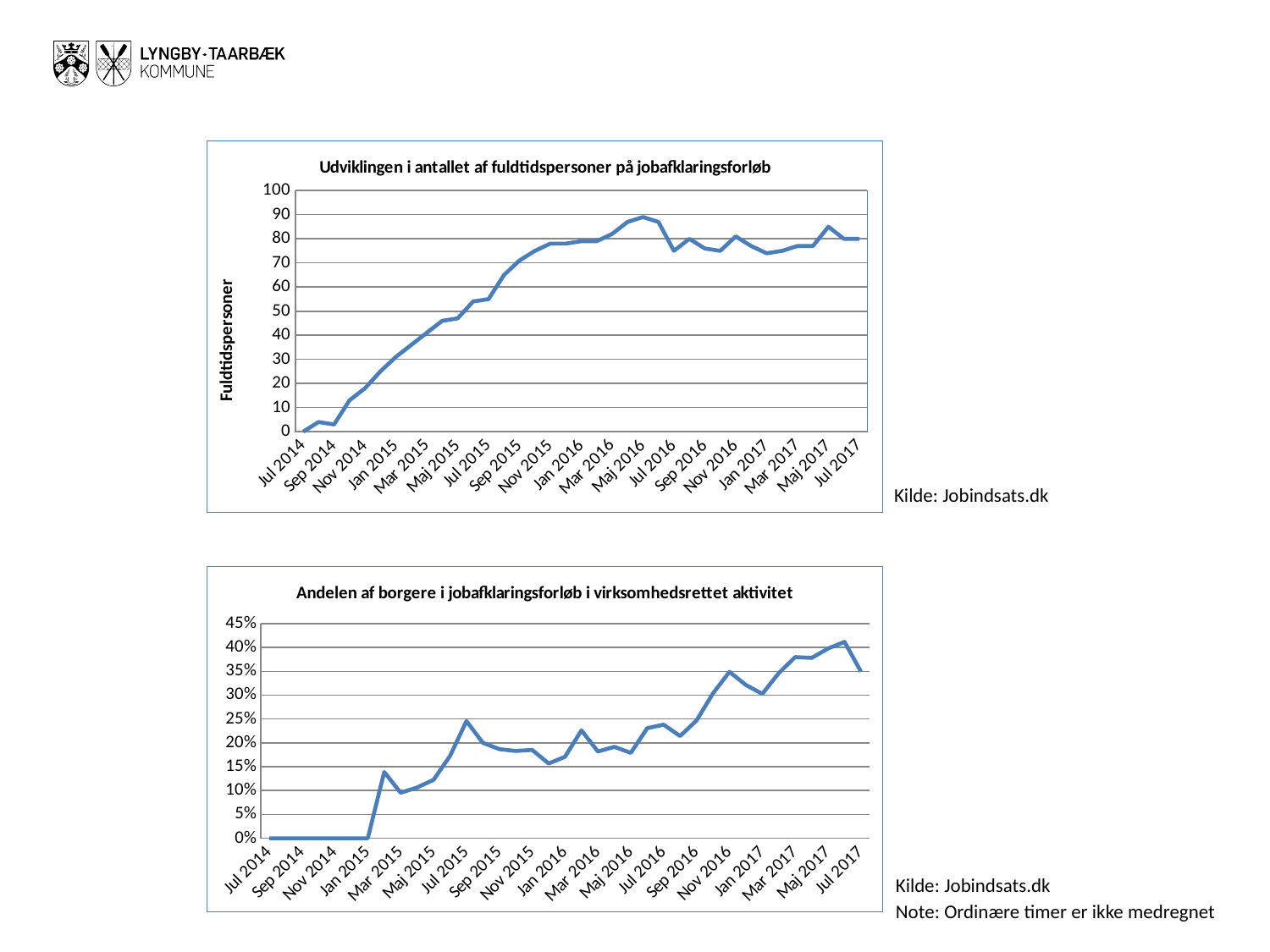
In the bottom chart, which is larger, the value for Jan 2016 or the value for Mar 2017? Mar 2017 In the top chart, which is larger, the value for Mar 2015 or the value for Sep 2015? Sep 2015 In the top chart, do the values generally rise or fall from Jul 2014 to Nov 2015? rise In the bottom chart, is the value for Nov 2016 greater or less than 30%? greater What kind of chart is the top chart, 'Udviklingen i antallet af fuldtidspersoner på jobafklaringsforløb'? line chart In the top chart, is the value for Maj 2016 greater or less than 80? greater In the bottom chart, what is the value for Jul 2014? 0% What kind of chart is the bottom chart, 'Andelen af borgere i jobafklaringsforløb i virksomhedsrettet aktivitet'? line chart In the top chart, what is the value for Jul 2014? 0 In the top chart, which month has the highest number of fuldtidspersoner? Maj 2016 In the top chart, which month has the lowest number of fuldtidspersoner? Jul 2014